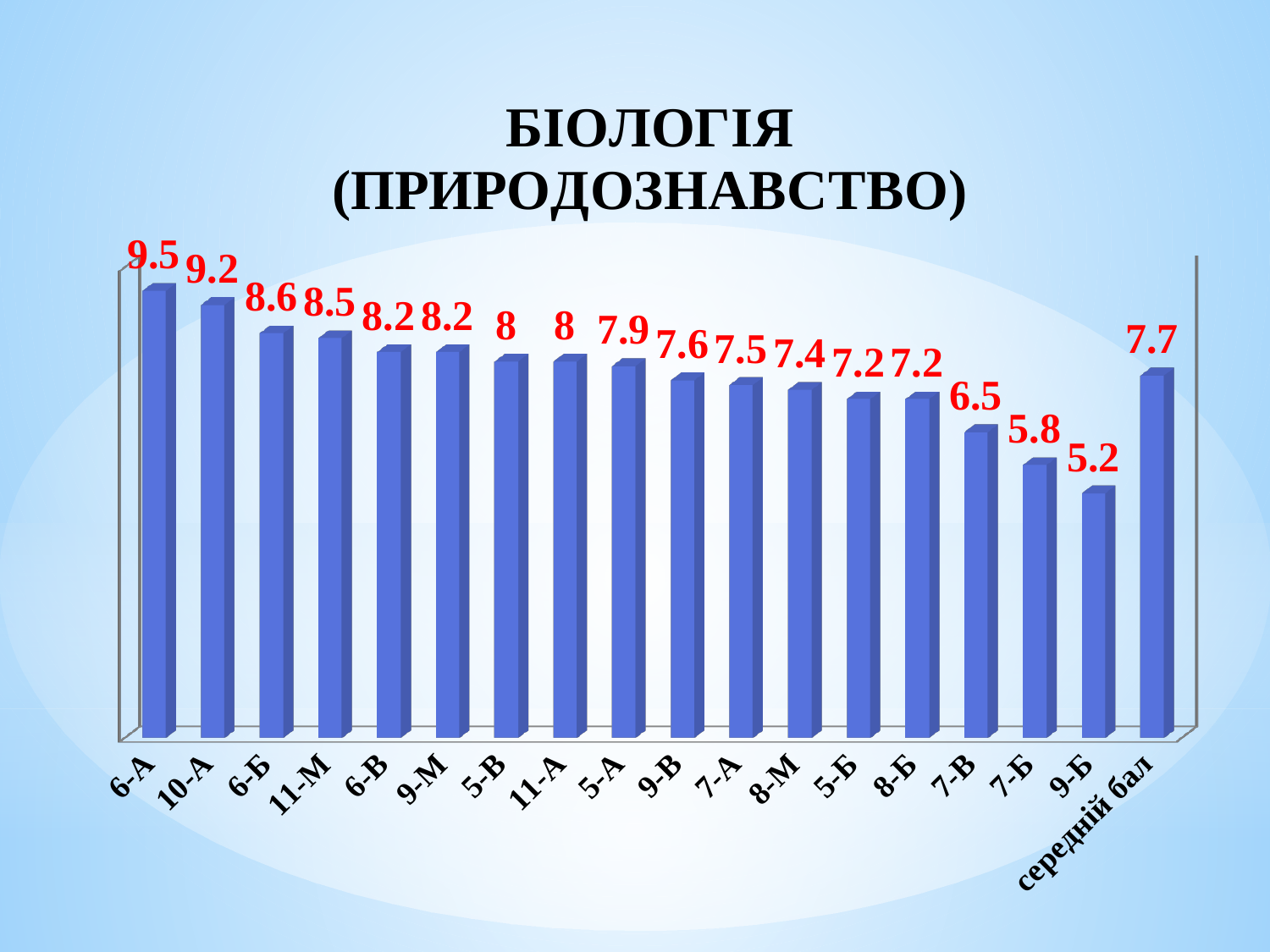
What is the title of the chart? БІОЛОГІЯ (ПРИРОДОЗНАВСТВО) Which is larger, the value for 7-Б or the value for 7-В? 7-В What is the value for 9-Б? 5.2 What kind of chart is shown on the slide? Bar chart What is the value for 11-М? 8.5 What is the value for середній бал? 7.7 Which category has the highest value? 6-А What is the difference between the values for 6-А and 9-Б? 4.3 Which category has the lowest value? 9-Б What is the value for 6-А? 9.5 What is the difference between the values for 10-А and 7-В? 2.7 How many bars are shown in the chart? 18